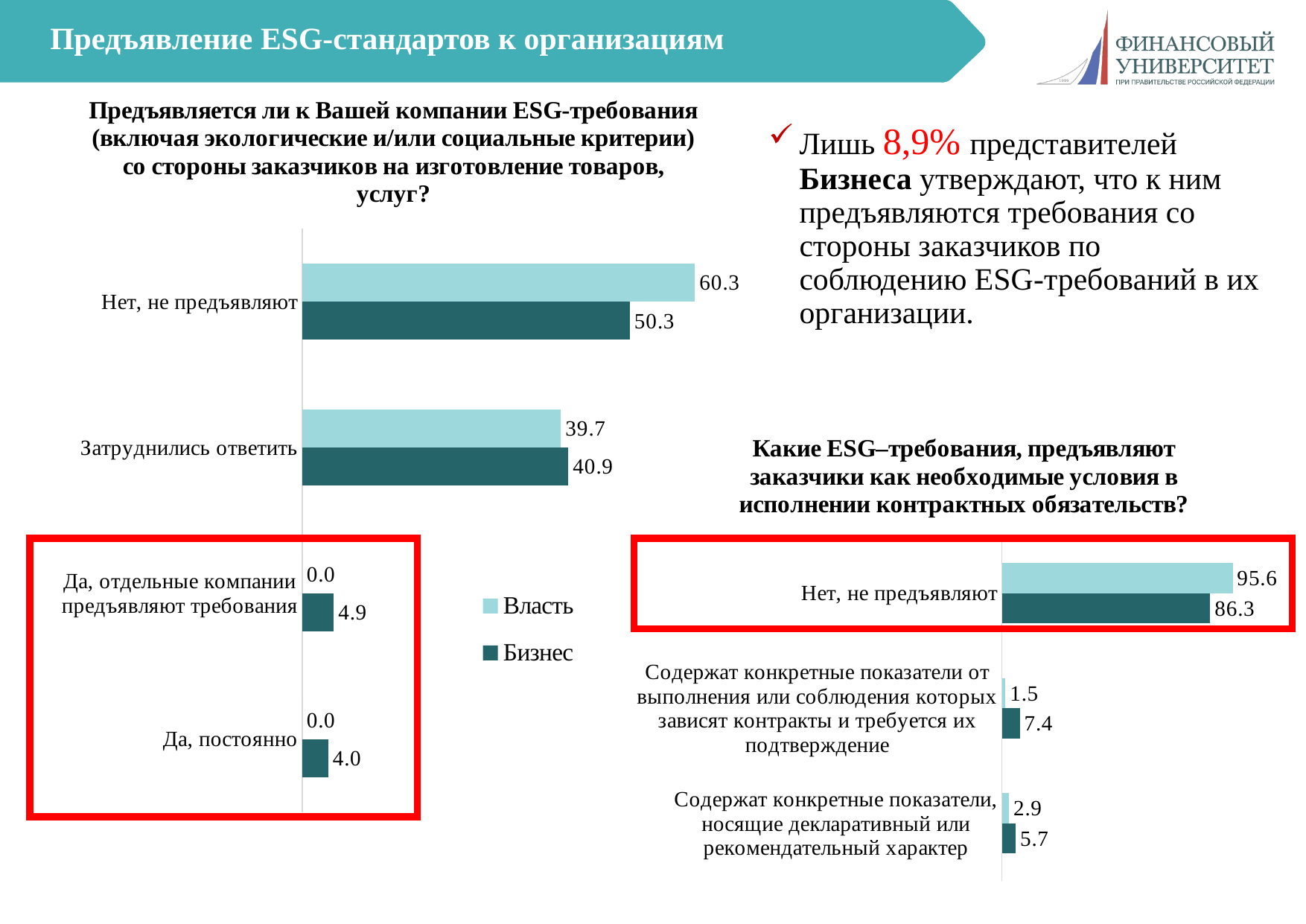
What type of chart is the left chart ("Предъявляется ли к Вашей компании ESG-требования...")? Bar chart In the right chart ("Какие ESG–требования, предъявляют заказчики..."), which category has the highest value for Бизнес? Нет, не предъявляют In the right chart ("Какие ESG–требования, предъявляют заказчики..."), what is the value for Власть in the category "Нет, не предъявляют"? 95.6 In the right chart ("Какие ESG–требования, предъявляют заказчики..."), which category has the lowest value for Власть? Содержат конкретные показатели от выполнения или соблюдения которых зависят контракты и требуется их подтверждение In the left chart ("Предъявляется ли к Вашей компании ESG-требования..."), which series has the larger value for "Затруднились ответить", Власть or Бизнес? Бизнес In the left chart ("Предъявляется ли к Вашей компании ESG-требования..."), what is the value for Бизнес in the category "Да, постоянно"? 4.0 In the left chart ("Предъявляется ли к Вашей компании ESG-требования..."), how many categories are shown? 4 In the left chart ("Предъявляется ли к Вашей компании ESG-требования..."), what is the value for Власть in the category "Нет, не предъявляют"? 60.3 In the right chart ("Какие ESG–требования, предъявляют заказчики..."), what is the difference between the Власть and Бизнес values for "Нет, не предъявляют"? 9.3 In the right chart ("Какие ESG–требования, предъявляют заказчики..."), what is the value for Бизнес in the category "Содержат конкретные показатели, носящие декларативный или рекомендательный характер"? 5.7 In the left chart ("Предъявляется ли к Вашей компании ESG-требования..."), what is the difference between the Власть and Бизнес values for "Нет, не предъявляют"? 10.0 In the left chart ("Предъявляется ли к Вашей компании ESG-требования..."), how many series does the legend list? 2